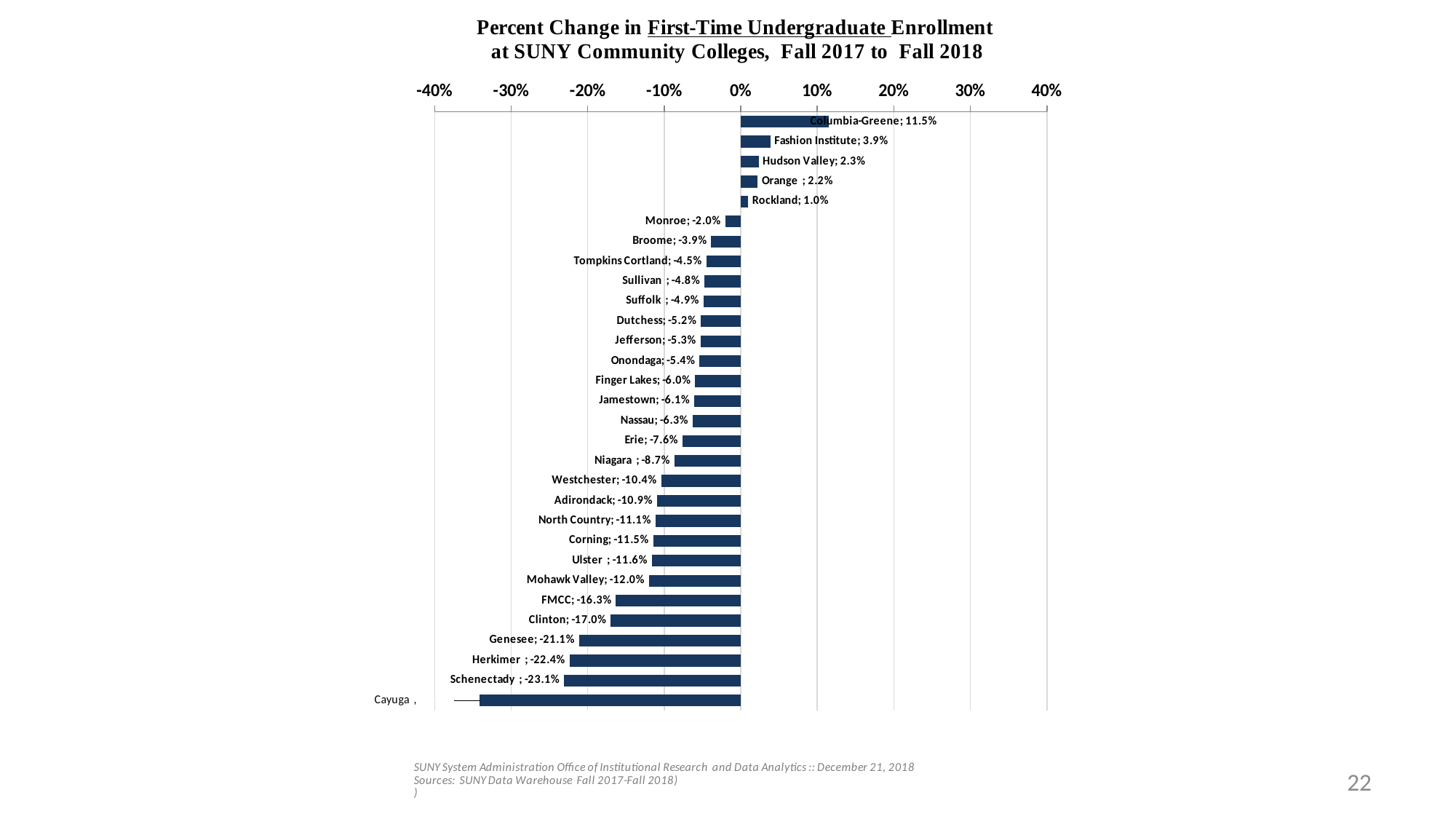
What is the percent change in first-time undergraduate enrollment for Westchester? -10.4% Which community college has the highest percent change in first-time undergraduate enrollment? Columbia-Greene What is the difference in percentage points between Columbia-Greene and Fashion Institute? 7.6 percentage points How many community colleges are shown in the chart? 30 Which community college has the lowest percent change in first-time undergraduate enrollment? Cayuga How many community colleges show a positive percent change? 5 Is the value for Cayuga greater or less than -30%? less Which has the larger percent change, Genesee or Herkimer? Genesee What type of chart is shown on the slide? Bar chart What is the percent change for Erie? -7.6% What is the percent change for Rockland? 1.0% What time period does the chart title say the percent change covers? Fall 2017 to Fall 2018